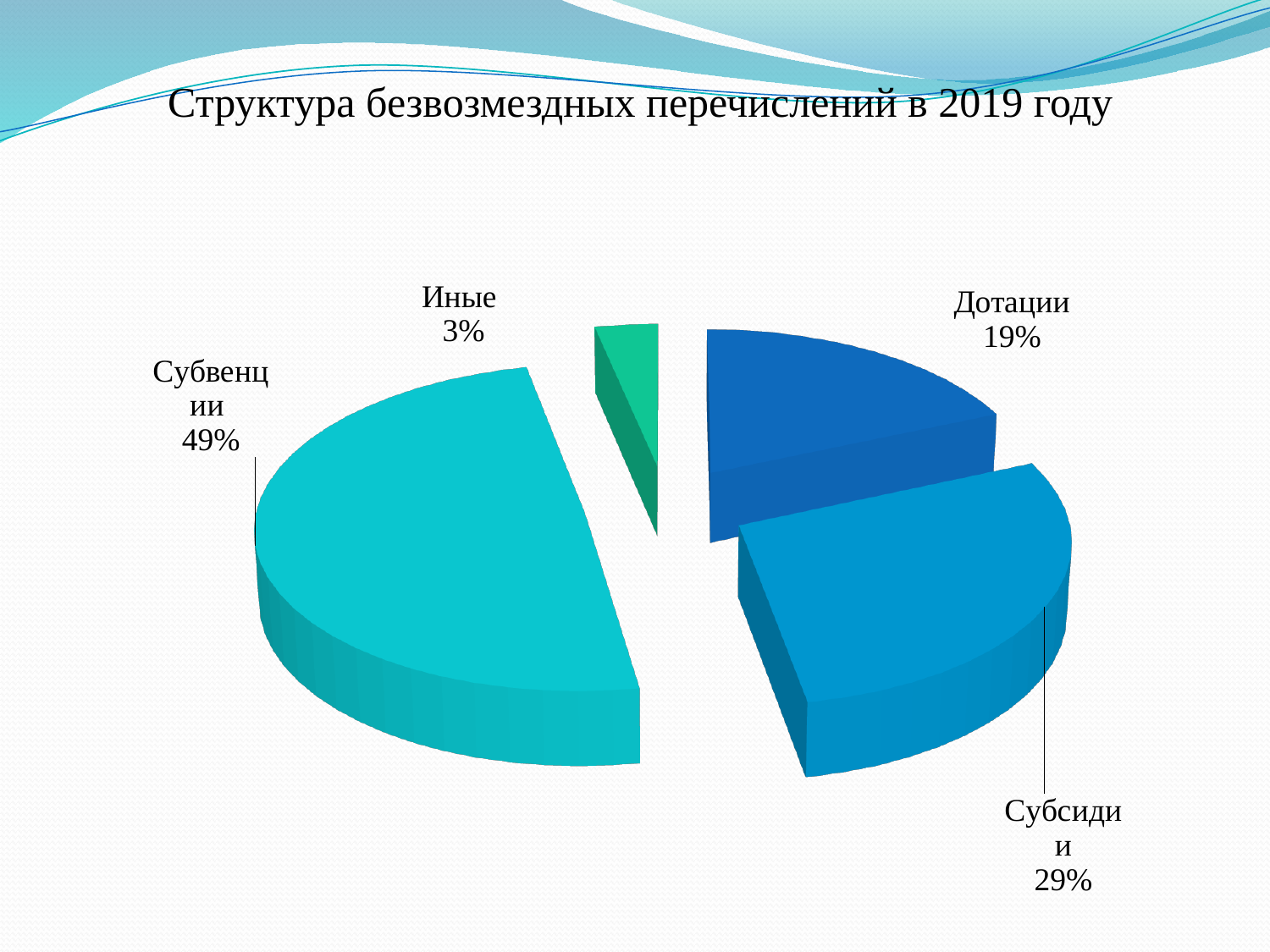
What kind of chart is shown on the slide? Pie chart What is the difference in percentage points between Субвенции and Субсидии? 20 Which is larger, Дотации or Субсидии? Субсидии What share of the pie does Субвенции represent? 49% What is the title of the chart? Структура безвозмездных перечислений в 2019 году What is the value shown for Субсидии? 29% What is the value shown for Дотации? 19% Which category has the smallest slice of the pie? Иные What is the value shown for Иные? 3% What is the difference in percentage points between Субсидии and Дотации? 10 How many categories are shown in the pie chart? 4 Which category has the largest slice of the pie? Субвенции